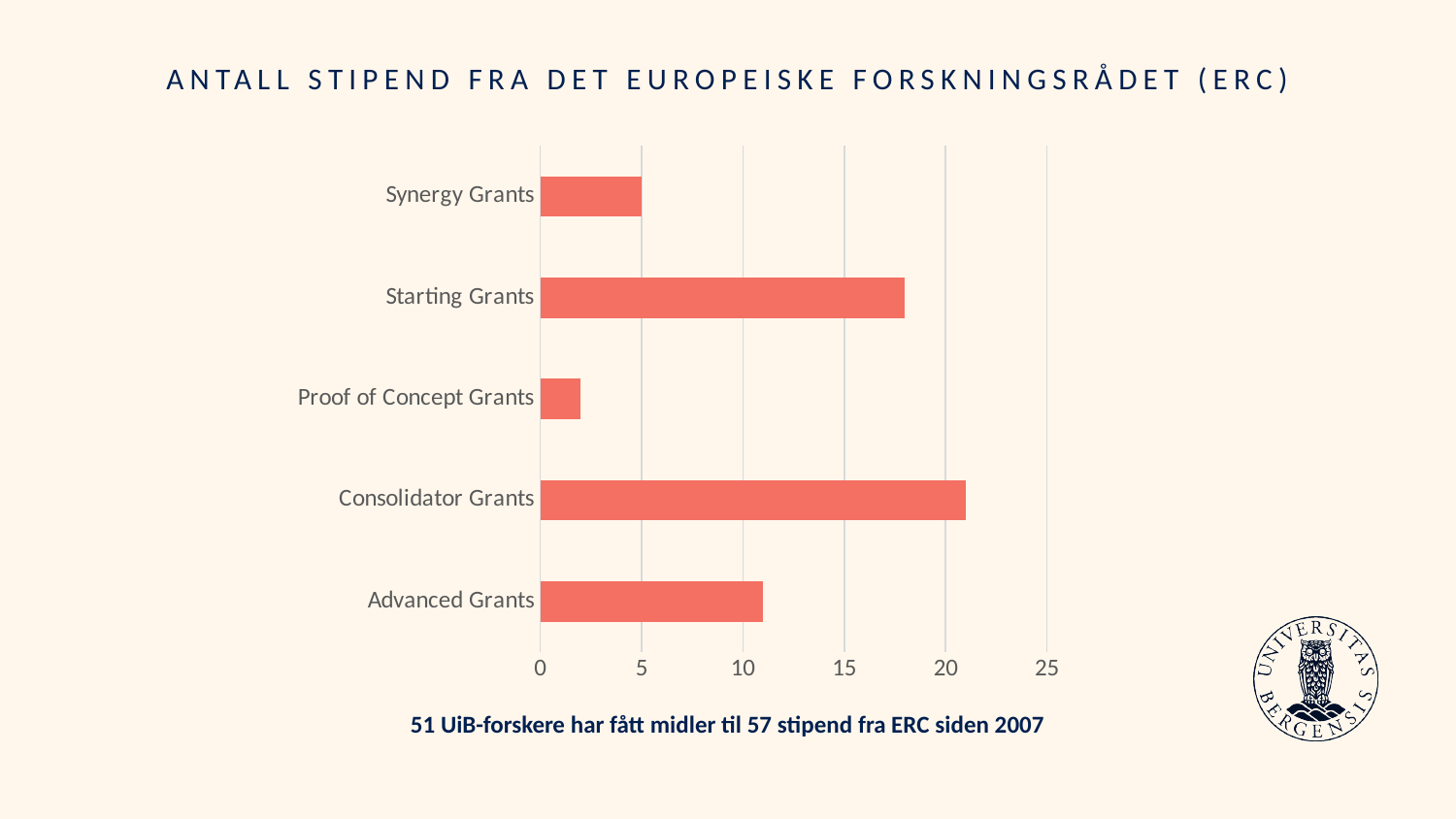
How many grant categories are shown in the chart? 5 Which is larger, the value for Starting Grants or the value for Advanced Grants? Starting Grants Is the value for Consolidator Grants greater or less than 20? greater Is the value for Starting Grants greater or less than 15? greater What is the title of the chart? ANTALL STIPEND FRA DET EUROPEISKE FORSKNINGSRÅDET (ERC) What is the value for Synergy Grants? 5 What is the highest value shown on the horizontal axis? 25 What kind of chart is shown on the slide? bar chart Is the value for Advanced Grants greater or less than 15? less Which grant category has the highest number of grants? Consolidator Grants Which grant category has the lowest number of grants? Proof of Concept Grants